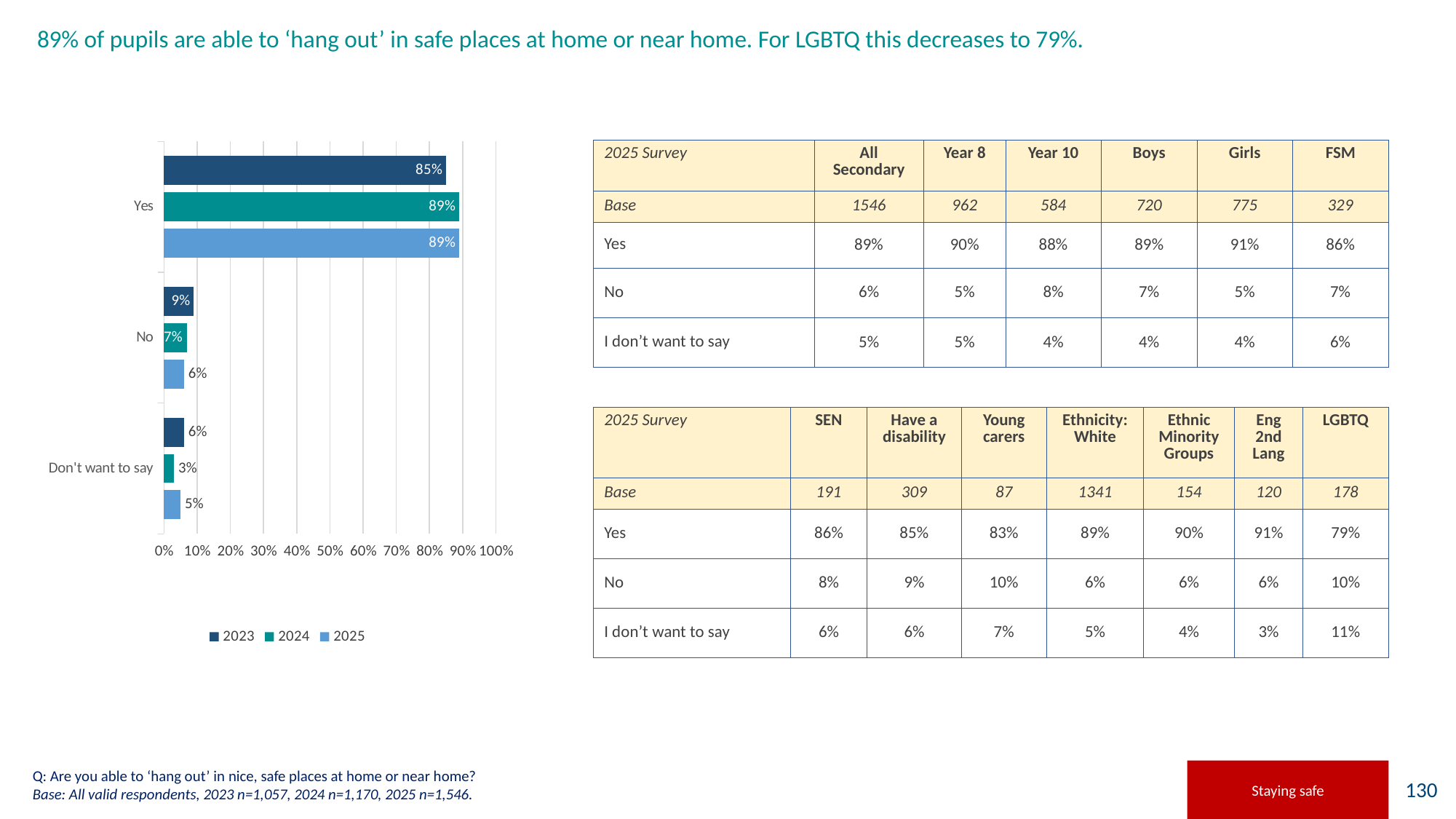
Which years are listed in the bar chart legend? 2023, 2024, 2025 What is the 2023 value for 'No' in the bar chart? 9% How many series does the bar chart legend list? 3 Which category has the highest 2024 value in the bar chart? Yes In the bar chart, is the 2023 value for 'No' larger or smaller than the 2025 value for 'No'? larger What is the 2024 value for 'Don't want to say' in the bar chart? 3% How many categories are shown on the bar chart? 3 What is the 2025 value for 'Yes' in the bar chart? 89% What is the difference between the 2024 and 2023 values for 'Yes' in the bar chart? 4% Is the 2023 value for 'Yes' in the bar chart greater or less than 80%? greater What kind of chart is shown on the slide? bar chart Which category has the lowest 2023 value in the bar chart? Don't want to say